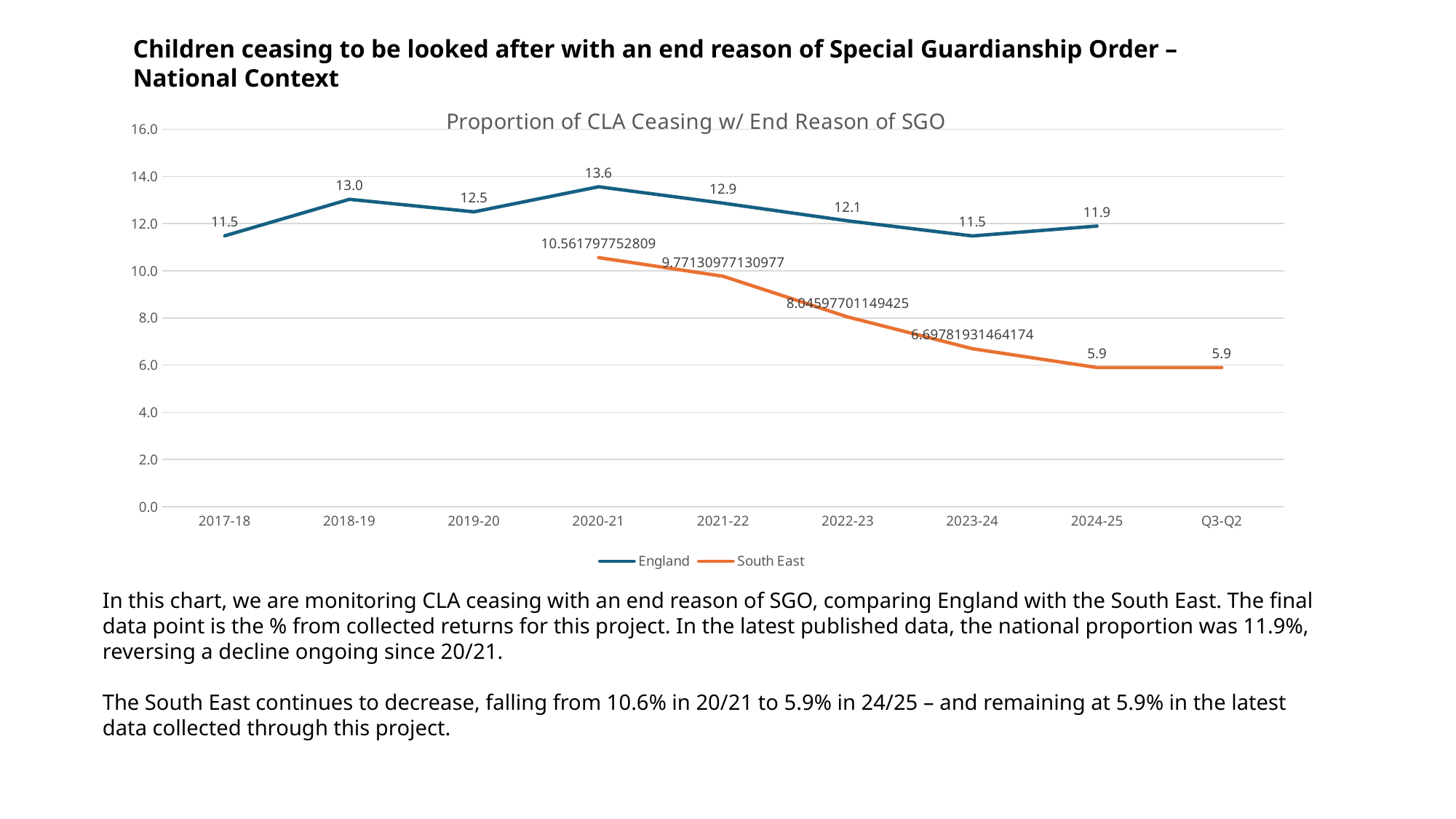
What is the England value for 2017-18? 11.5 Which is larger in 2021-22, the England value or the South East value? England Is the South East value for 2022-23 greater or less than 10.0? less What is the England value for 2020-21? 13.6 Does the South East series rise or fall from 2020-21 to 2024-25? fall What is the South East value for 2024-25? 5.9 What is the difference between the England values for 2020-21 and 2023-24? 2.1 What kind of chart is this? line chart In which year does the England series reach its lowest value? 2017-18 and 2023-24 In which year does the England series reach its highest value? 2020-21 How many periods are shown on the x axis? 9 How many series does the legend list? 2